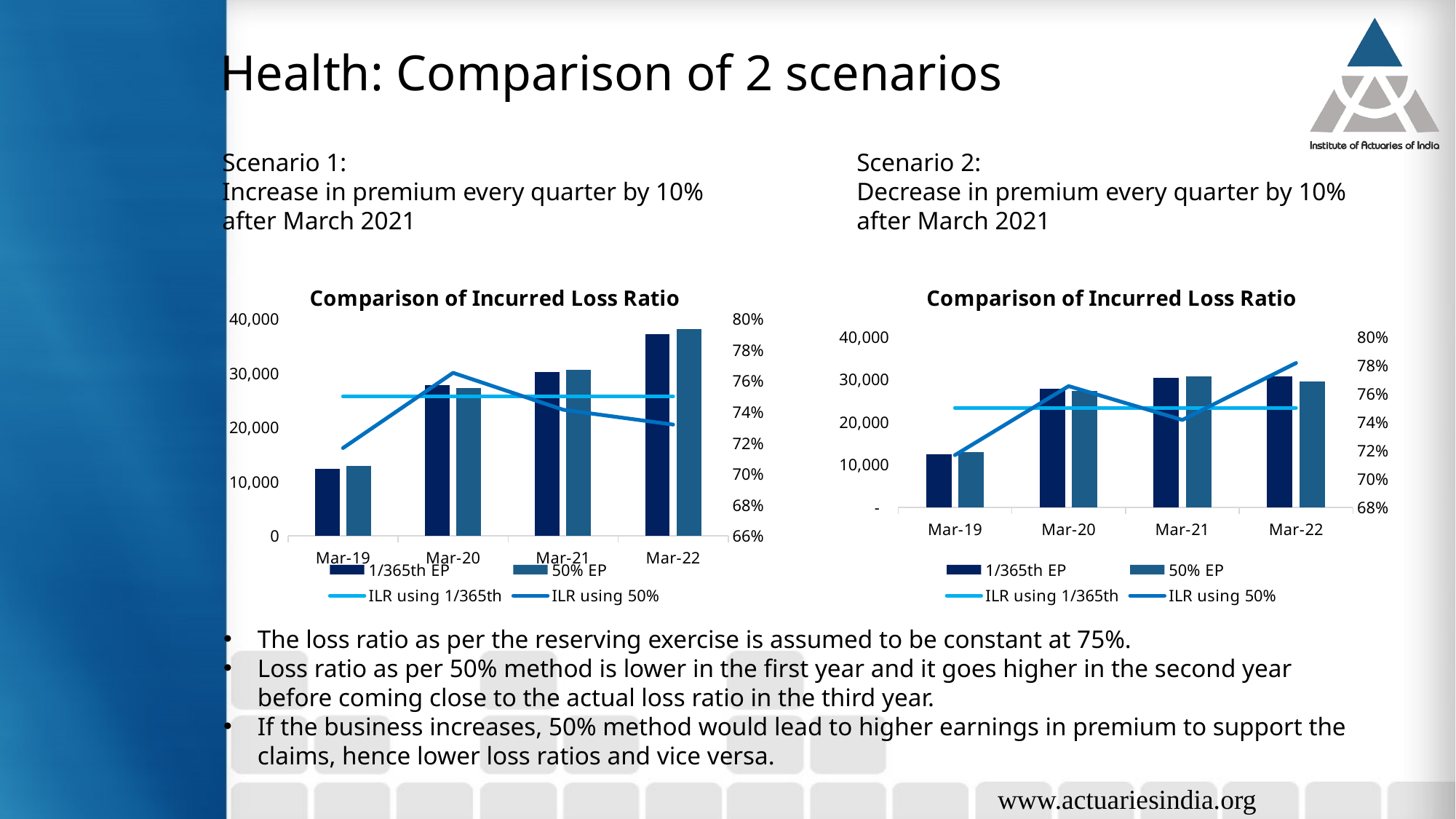
In the left chart (Scenario 1), how many time periods are shown on the x axis? 4 In the left chart (Scenario 1), is the ILR using 50% value for Mar-19 greater or less than 74%? less In the left chart (Scenario 1), is the 1/365th EP value for Mar-22 greater or less than 30,000? greater In the right chart (Scenario 2), which line series stays flat across all periods? ILR using 1/365th In the right chart (Scenario 2), which period has the lowest 50% EP bar? Mar-19 In the left chart (Scenario 1), which is larger: the 1/365th EP bar for Mar-22 or for Mar-21? Mar-22 In the left chart (Scenario 1), do the 1/365th EP bars rise or fall from Mar-19 to Mar-22? Rise In the right chart (Scenario 2), is the 1/365th EP value for Mar-19 greater or less than 20,000? less What kind of chart is the left chart titled 'Comparison of Incurred Loss Ratio' under Scenario 1? Combined bar and line chart In the right chart (Scenario 2), how many series does the legend list? 4 In the left chart (Scenario 1), which period has the highest 1/365th EP bar? Mar-22